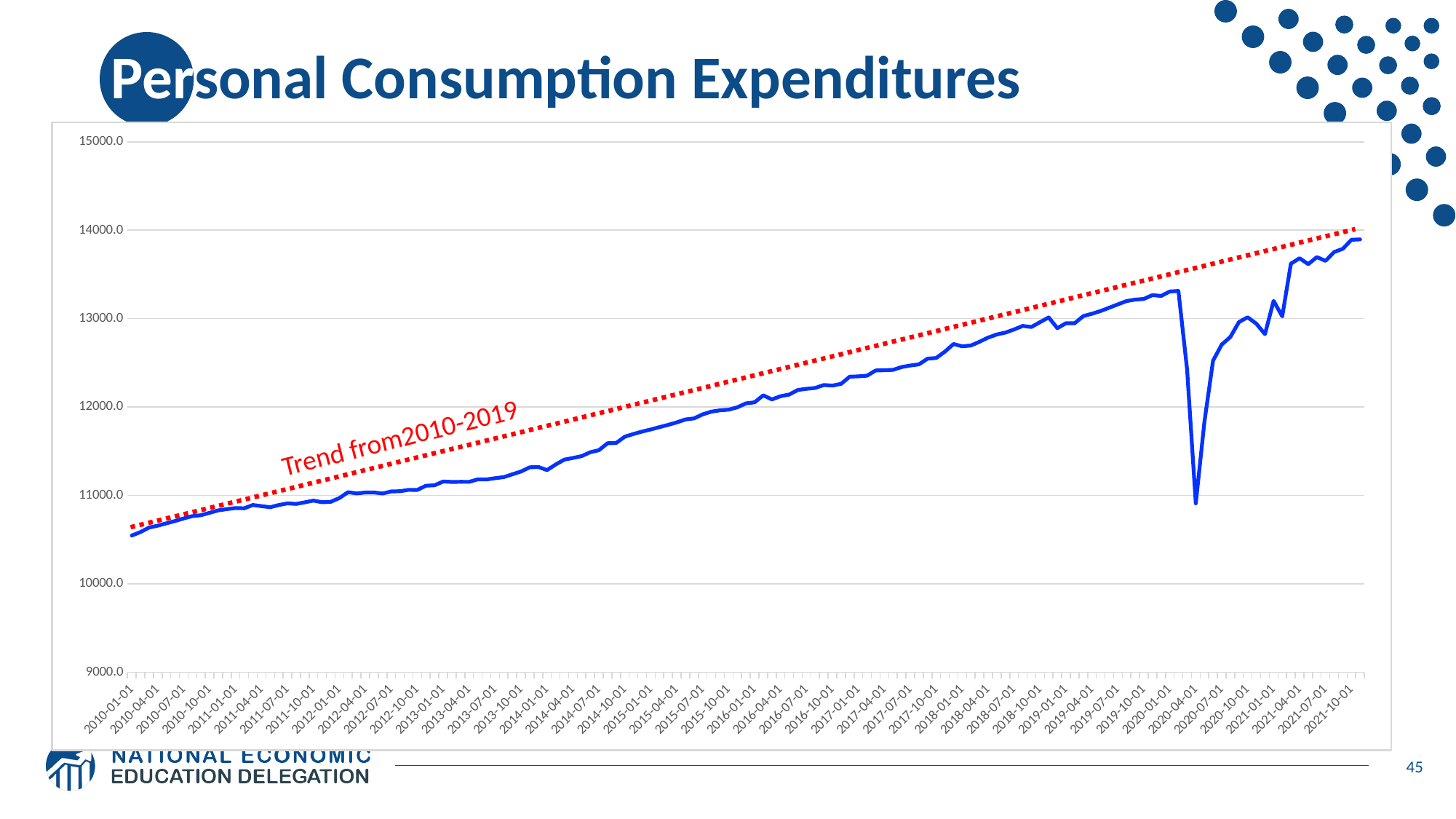
What is the title of the slide's chart? Personal Consumption Expenditures Is the lowest value in 2020 greater or less than 12000? less Is the value at 2021-10-01 greater or less than 13000? greater What is the highest value shown on the vertical axis? 15000.0 Is the value at 2020-01-01 greater or less than 13000? greater Which is larger, the value at 2019-10-01 or the value at 2020-04-01? 2019-10-01 What does the label on the red dotted line say? Trend from2010-2019 What kind of chart is shown on the slide? line chart Overall, do the plotted values rise or fall from 2010-01-01 to 2021-10-01? rise